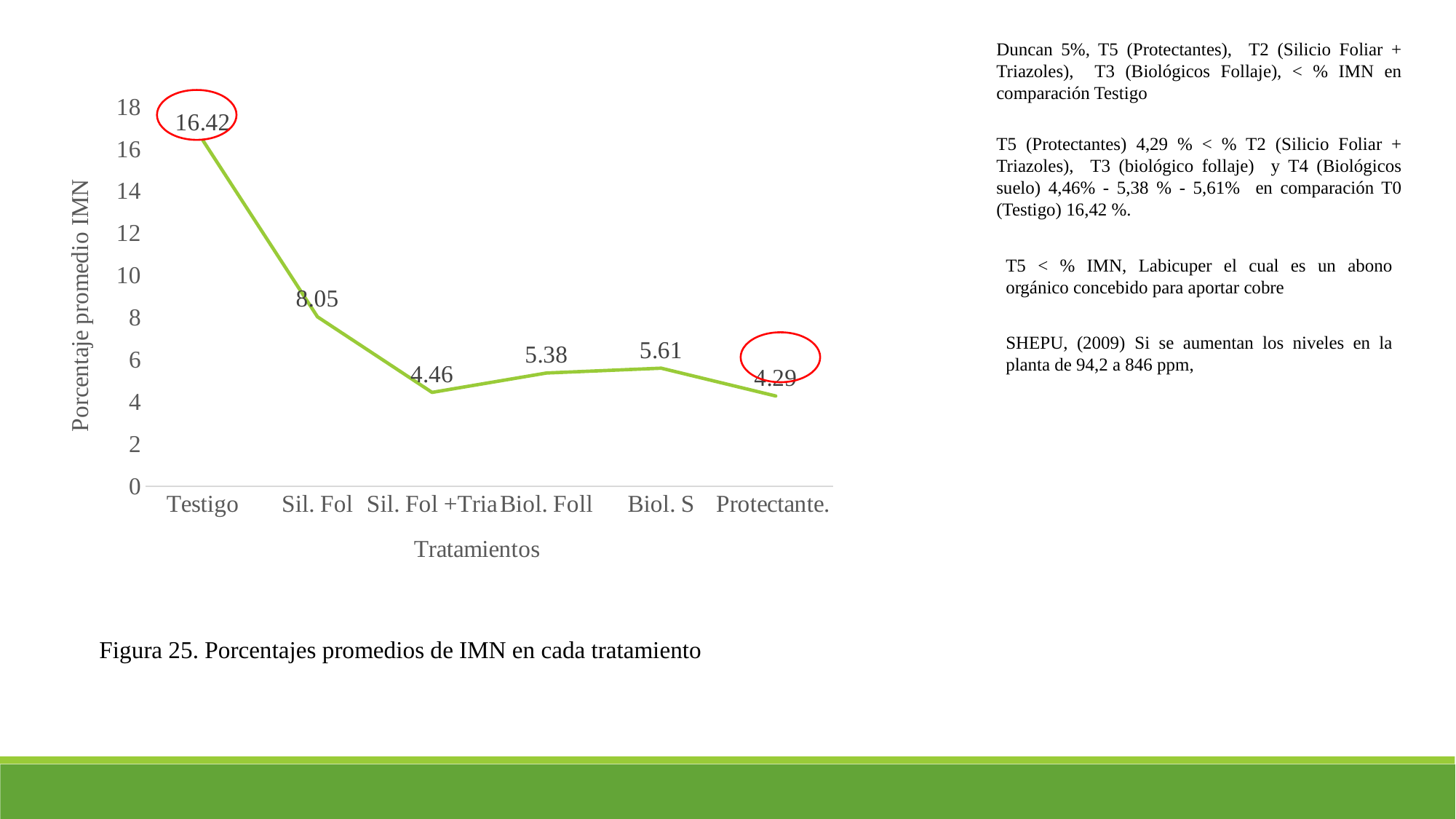
What is the value for Sil. Fol? 8.05 Which is larger, the value for Sil. Fol +Tria or the value for Biol. Foll? Biol. Foll How many treatments are plotted on the x axis? 6 What is the value for Testigo? 16.42 What is the difference between the values for Testigo and Sil. Fol? 8.37 What is the value for Biol. S? 5.61 What is the value for Protectante.? 4.29 Which treatment has the lowest value? Protectante. What is the difference between the values for Biol. S and Biol. Foll? 0.23 What is the label of the y axis? Porcentaje promedio IMN What kind of chart is this? line chart Which treatment has the highest value? Testigo